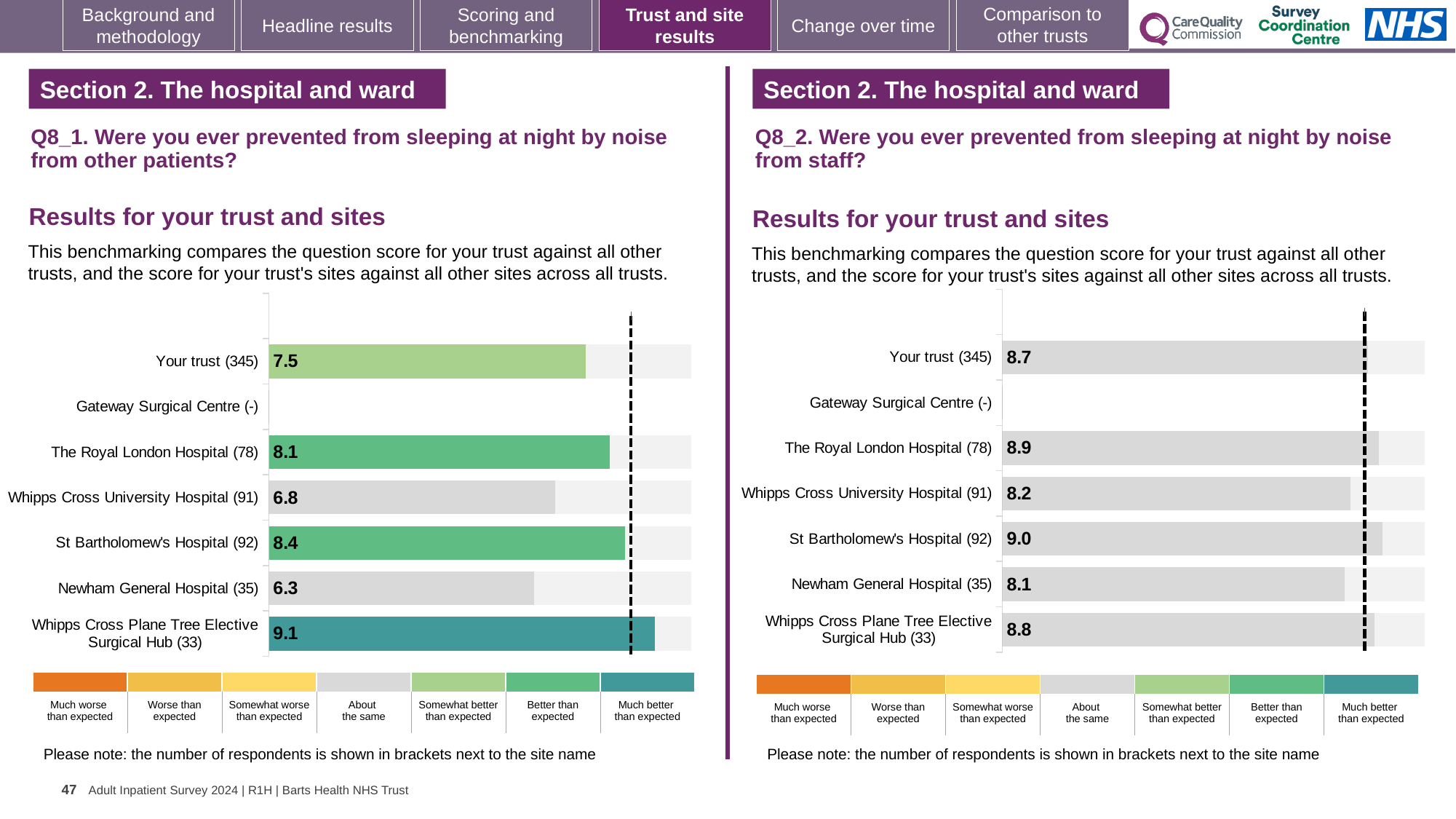
On the Q8_1 chart (left), which site has no score shown? Gateway Surgical Centre (-) On the Q8_2 chart (right), what is the difference between the scores for The Royal London Hospital (78) and Your trust (345)? 0.2 On the Q8_2 chart (right), what is the score for St Bartholomew's Hospital (92)? 9.0 On the Q8_2 chart (right), which site has the lowest score? Newham General Hospital (35) On the Q8_2 chart (right), what is the score for Newham General Hospital (35)? 8.1 On the Q8_1 chart (left), what is the difference between the scores for St Bartholomew's Hospital (92) and Whipps Cross University Hospital (91)? 1.6 What kind of chart is used on the Q8_2 chart (right)? Bar chart On the Q8_2 chart (right), which has the higher score: Whipps Cross University Hospital (91) or Whipps Cross Plane Tree Elective Surgical Hub (33)? Whipps Cross Plane Tree Elective Surgical Hub (33) On the Q8_1 chart (left), which site has the lowest score? Newham General Hospital (35) On the Q8_1 chart (left), which site has the highest score? Whipps Cross Plane Tree Elective Surgical Hub (33) On the Q8_1 chart (left), what is the score for Your trust (345)? 7.5 On the Q8_1 chart (left), how many sites or categories are listed on the vertical axis? 7